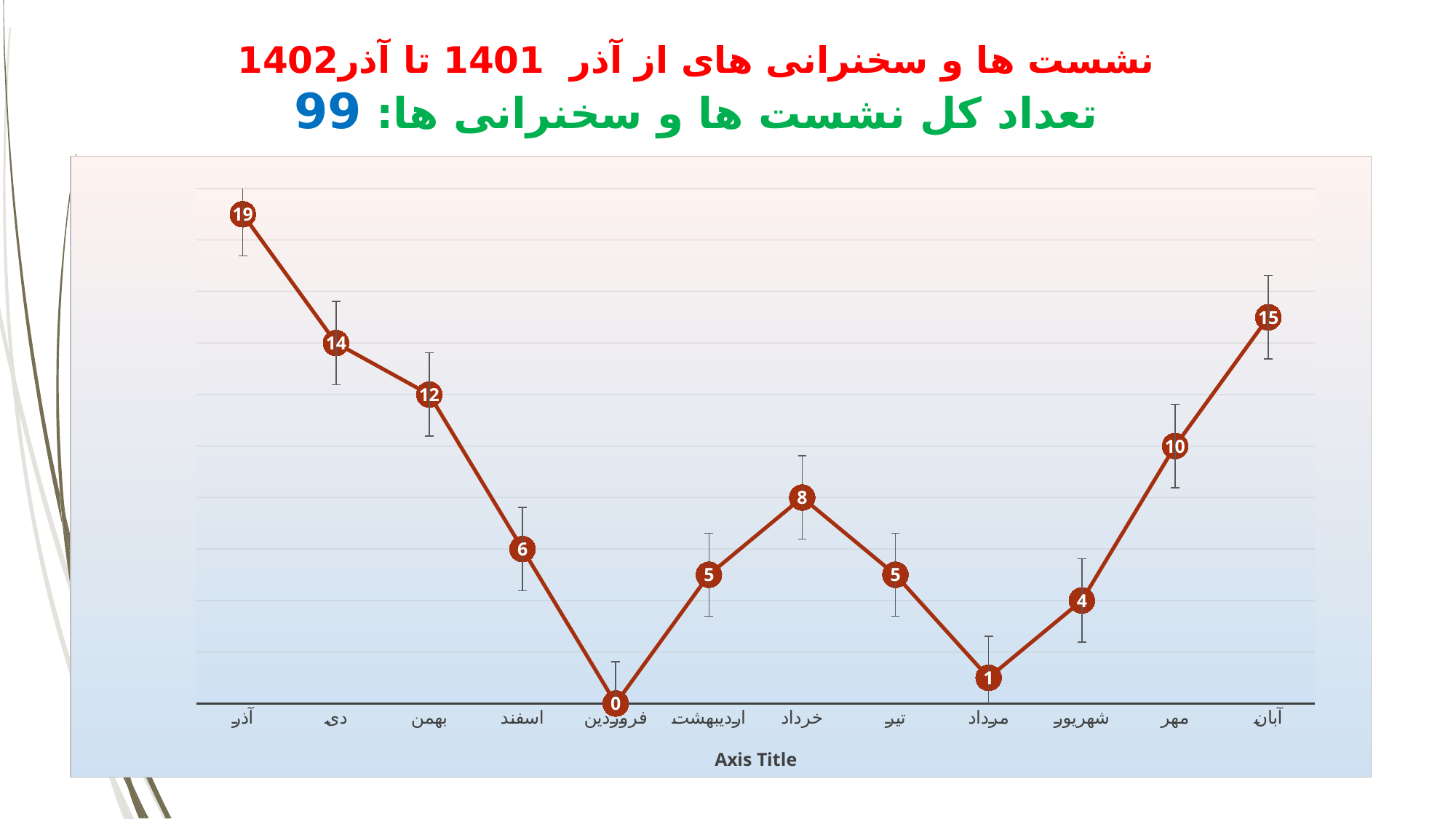
What is the value for مهر? 10 What is the x-axis title shown on the chart? Axis Title Which is larger, the value for بهمن or the value for مهر? بهمن Do the values rise or fall from آذر to فروردین? fall What is the value for آذر? 19 What kind of chart is shown on the slide? line chart What is the difference between the values for آذر and دی? 5 Which month has the lowest value? فروردین How many months are plotted on the chart? 12 What is the value for آبان? 15 What is the value for خرداد? 8 Which month has the highest value? آذر